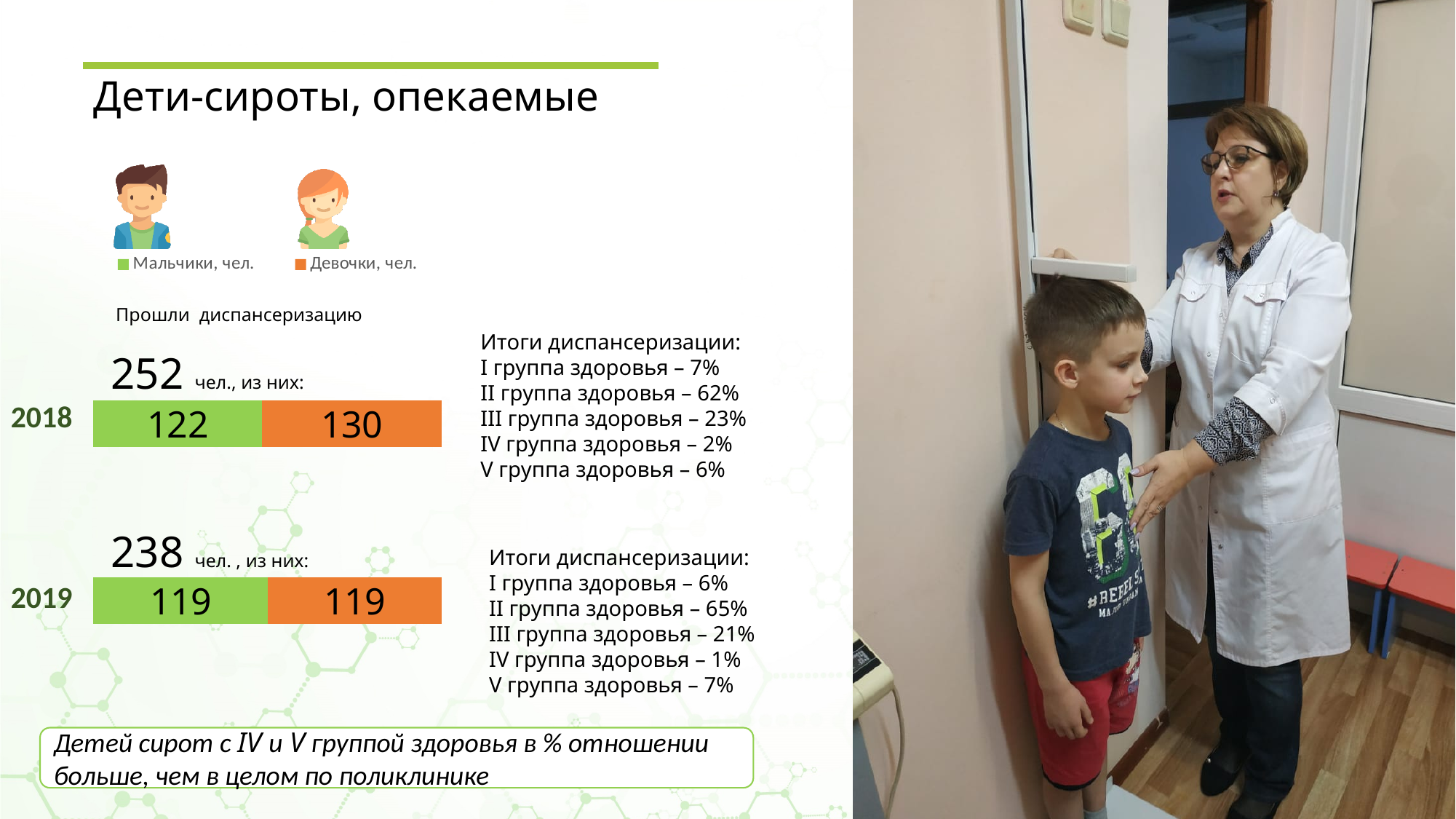
What is the value for Девочки in 2019? 119 How many years (categories) are shown in the chart? 2 What is the difference between the Девочки value in 2018 and the Девочки value in 2019? 11 What is the total of the stacked bar for 2018? 252 What is the value for Девочки in 2018? 130 What type of chart is shown on the slide? bar chart What is the total of the stacked bar for 2019? 238 In 2018, which is larger: the value for Мальчики or the value for Девочки? Девочки How many series does the legend list? 2 What is the value for Мальчики in 2019? 119 What are the two series named in the legend? Мальчики, чел. and Девочки, чел. What is the value for Мальчики in 2018? 122